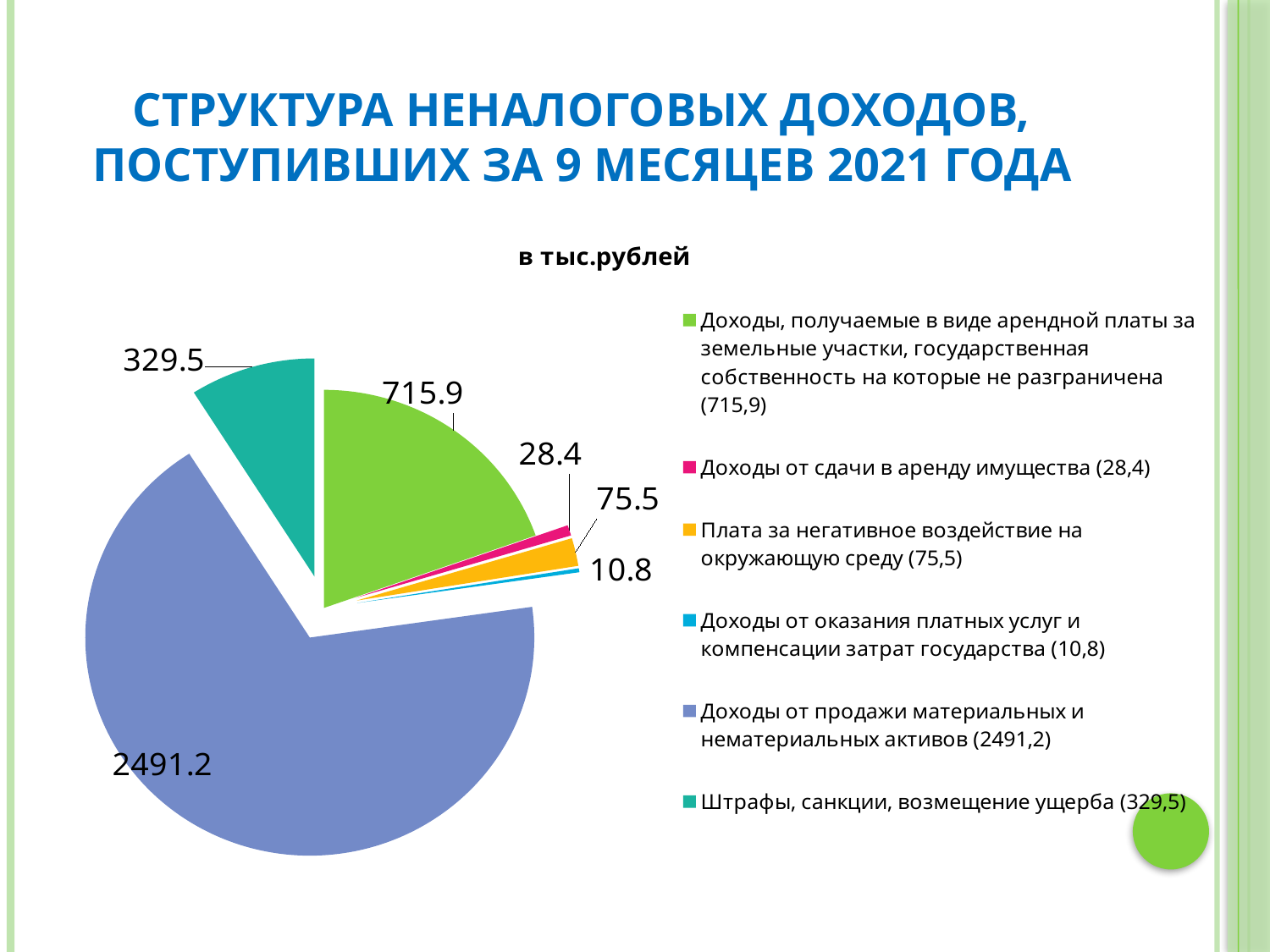
What is the value for «Плата за негативное воздействие на окружающую среду»? 75.5 What kind of chart is shown on the slide? pie chart Which category has the largest slice of the pie? Доходы от продажи материальных и нематериальных активов What is the value for «Доходы от сдачи в аренду имущества»? 28.4 What is the difference between the value for «Доходы, получаемые в виде арендной платы за земельные участки...» (715.9) and «Штрафы, санкции, возмещение ущерба» (329.5)? 386.4 Which category has the smallest slice of the pie? Доходы от оказания платных услуг и компенсации затрат государства What is the value for «Штрафы, санкции, возмещение ущерба»? 329.5 How many entries does the legend list? 6 What unit is stated in the chart title above the pie? в тыс.рублей Which is larger: the value for «Плата за негативное воздействие на окружающую среду» or for «Доходы от сдачи в аренду имущества»? Плата за негативное воздействие на окружающую среду What is the value for «Доходы от продажи материальных и нематериальных активов»? 2491.2 How many slices does the pie chart have? 6